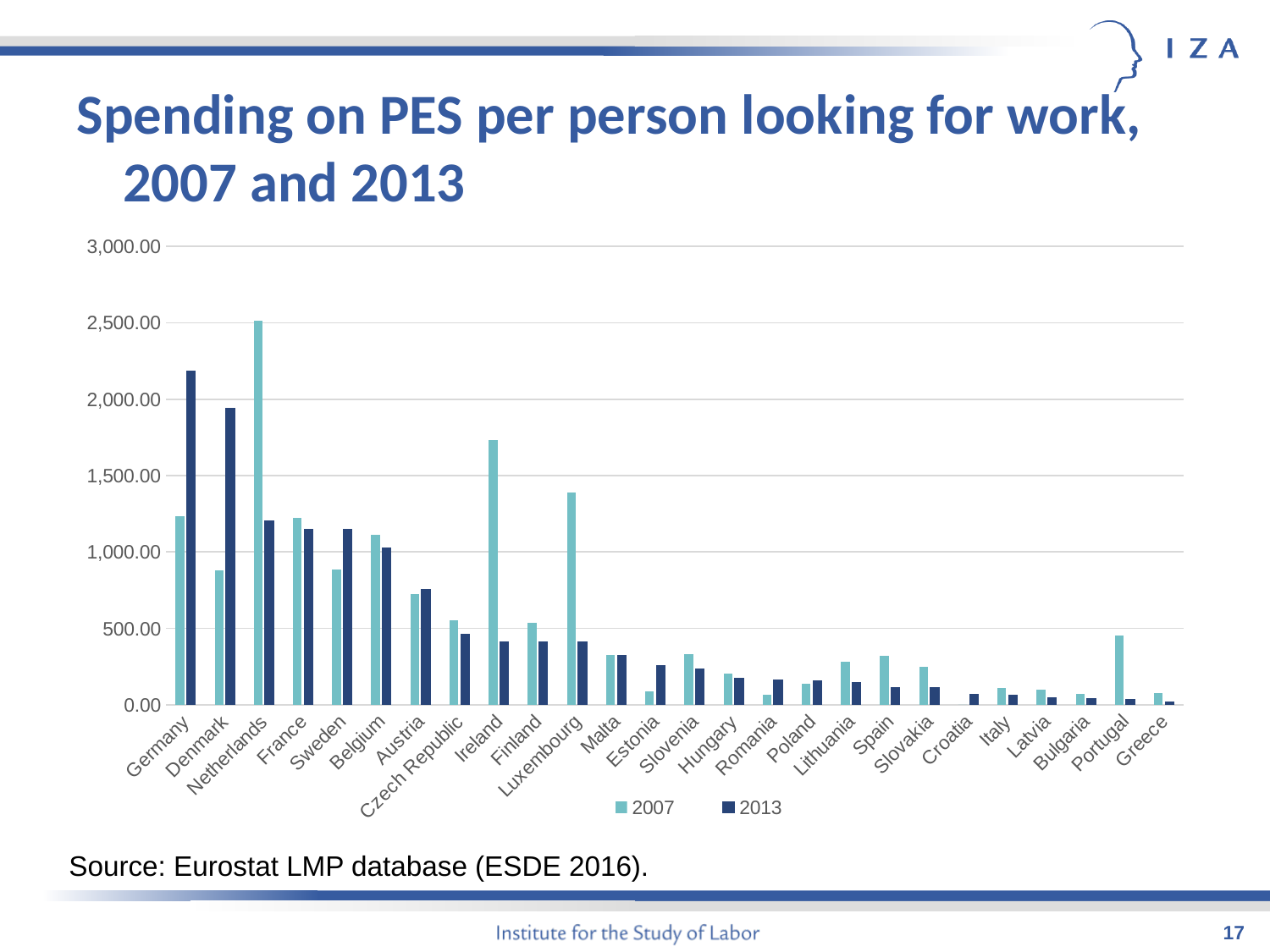
How many countries are shown on the x axis? 26 Which country has the highest 2007 value? Netherlands Is the 2013 value for Germany greater or less than 2,000.00? greater Is the 2007 value for Ireland greater or less than 1,500.00? greater Is the 2007 value for Luxembourg greater or less than 1,500.00? less Which country has the highest 2013 value? Germany Which country has the lowest 2013 value? Greece What kind of chart is shown on the slide? Bar chart For the Netherlands, which is larger: the 2007 value or the 2013 value? 2007 Do the 2013 values generally rise or fall moving from left to right along the x axis? Fall For Germany, which is larger: the 2007 value or the 2013 value? 2013 How many series does the legend list? 2